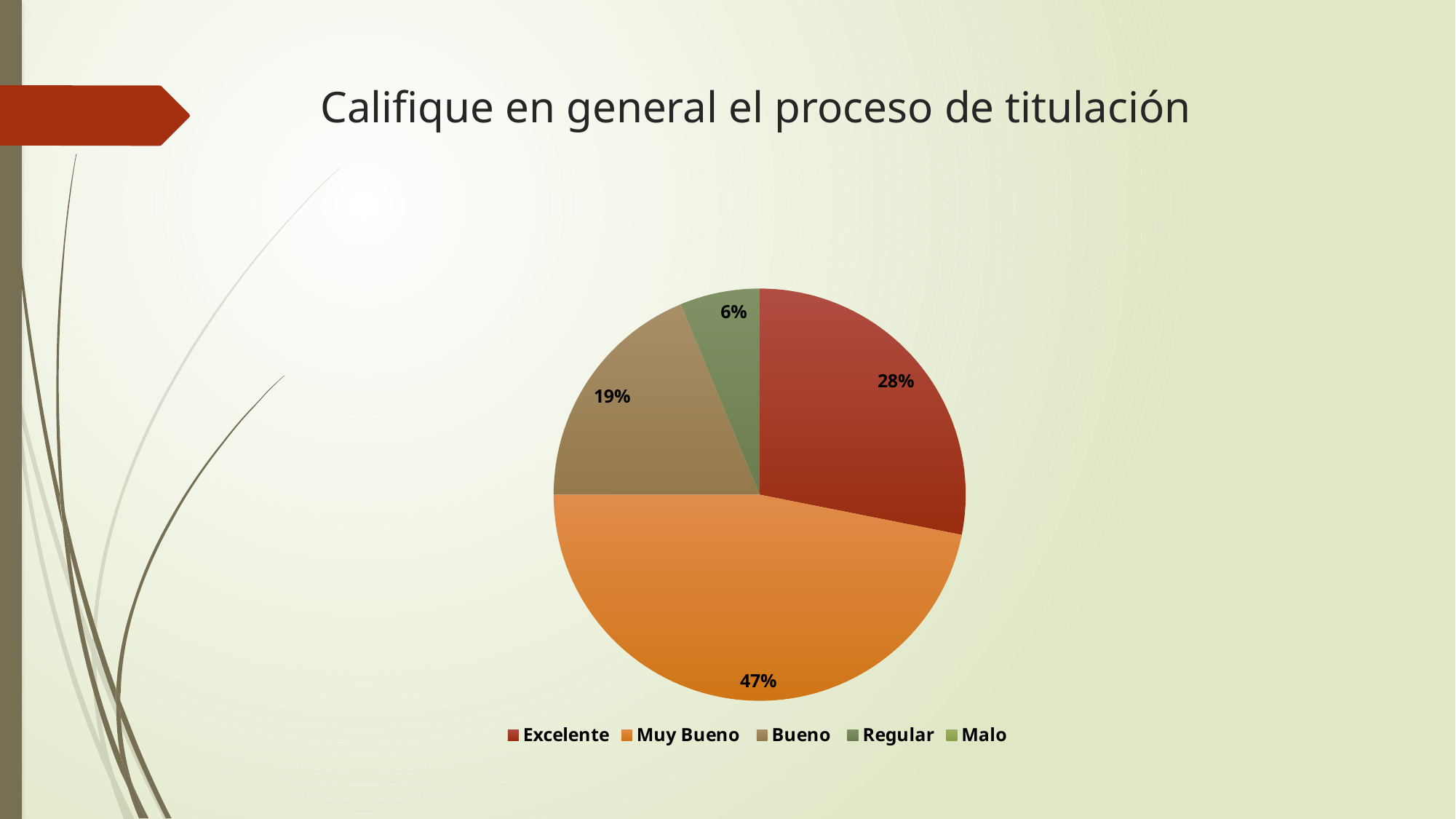
What is the title of the slide? Califique en general el proceso de titulación What percentage of responses were "Excelente"? 28% What colour is the "Muy Bueno" slice? orange What percentage of responses were "Muy Bueno"? 47% What percentage of responses were "Regular"? 6% What percentage of responses were "Bueno"? 19% What kind of chart is shown on the slide? pie chart Which category has the largest share of the pie? Muy Bueno What is the difference in percentage points between "Muy Bueno" and "Excelente"? 19 Which category with a visible slice has the smallest share of the pie? Regular How many categories does the legend list? 5 Which is larger, the share for "Bueno" or the share for "Excelente"? Excelente